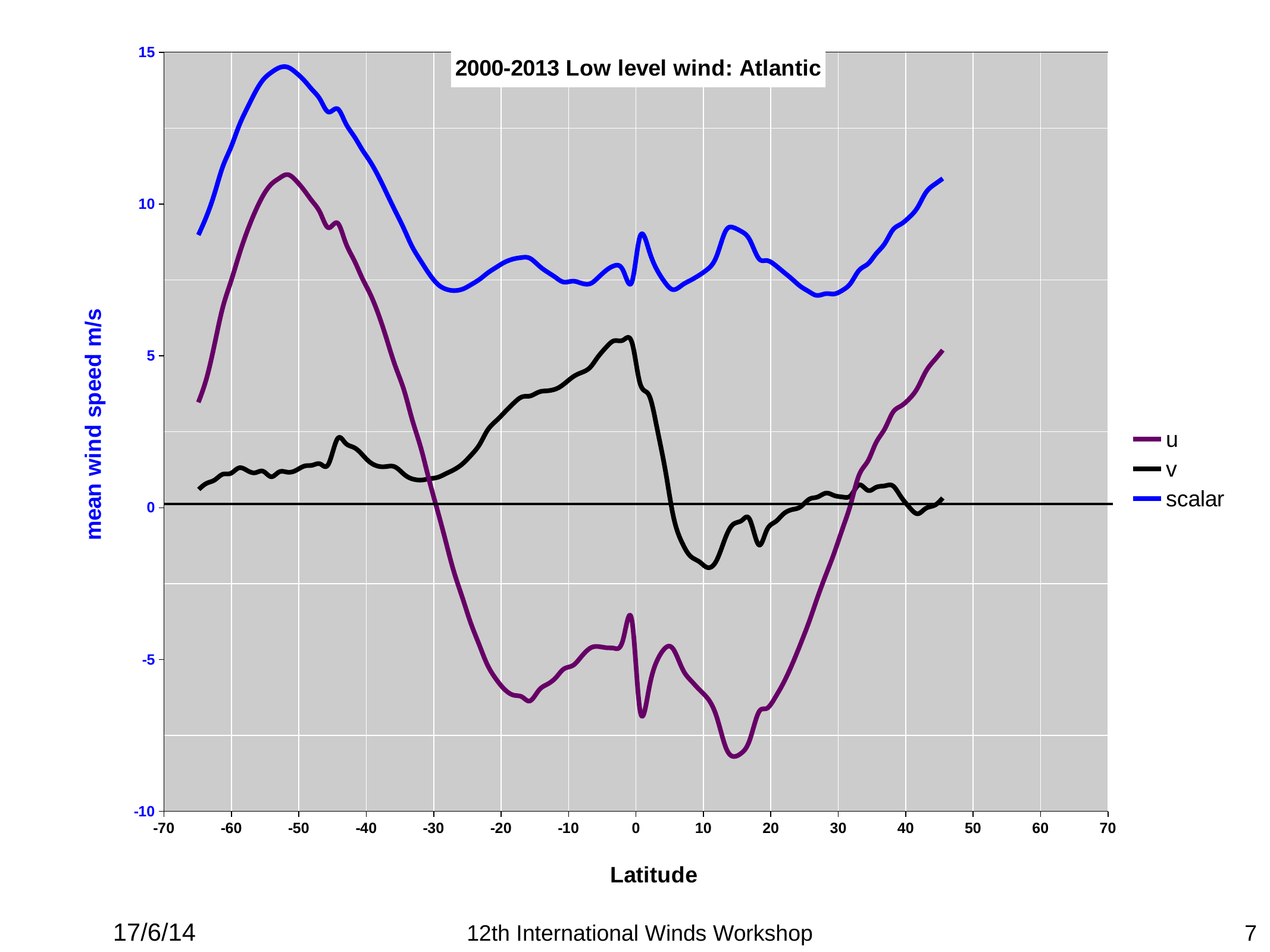
How many series does the legend list? 3 Is the value of the u series at latitude 15 greater or less than -5? less What is the label of the y axis? mean wind speed m/s At latitude 40, which series has the larger value, u or v? u At latitude 0, which series has the larger value, u or v? v Is the value of the scalar series at latitude -50 greater or less than 10? greater Is the value of the v series at latitude 10 greater or less than 0? less What is the title of the chart? 2000-2013 Low level wind: Atlantic Which series has the highest value at latitude -20? scalar Does the u series rise or fall between latitude -50 and latitude -20? fall What kind of chart is shown on the slide? line chart